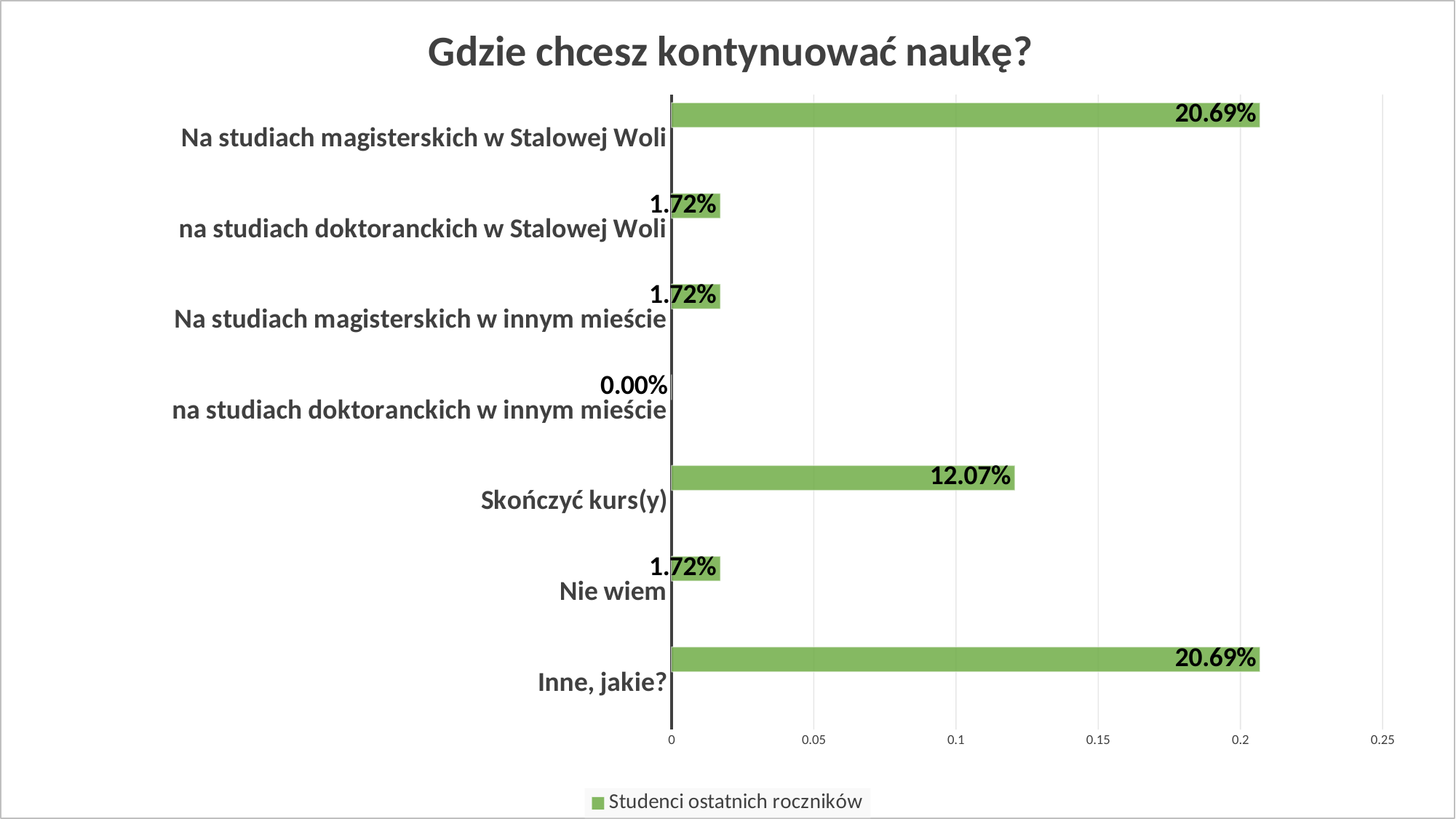
What is the title of the chart? Gdzie chcesz kontynuować naukę? How many categories are shown in the chart? 7 How many series does the legend list? 1 What is the value for 'Nie wiem'? 1.72% What is the value for 'na studiach doktoranckich w innym mieście'? 0.00% Which is larger: the value for 'Skończyć kurs(y)' or the value for 'Na studiach magisterskich w innym mieście'? Skończyć kurs(y) What type of chart is shown on the slide? bar chart What is the difference between the values for 'Inne, jakie?' and 'Skończyć kurs(y)'? 8.62% Which category has the lowest value? na studiach doktoranckich w innym mieście What is the value for 'Skończyć kurs(y)'? 12.07% What is the value for 'Na studiach magisterskich w Stalowej Woli'? 20.69% What is the name of the series shown in the legend? Studenci ostatnich roczników